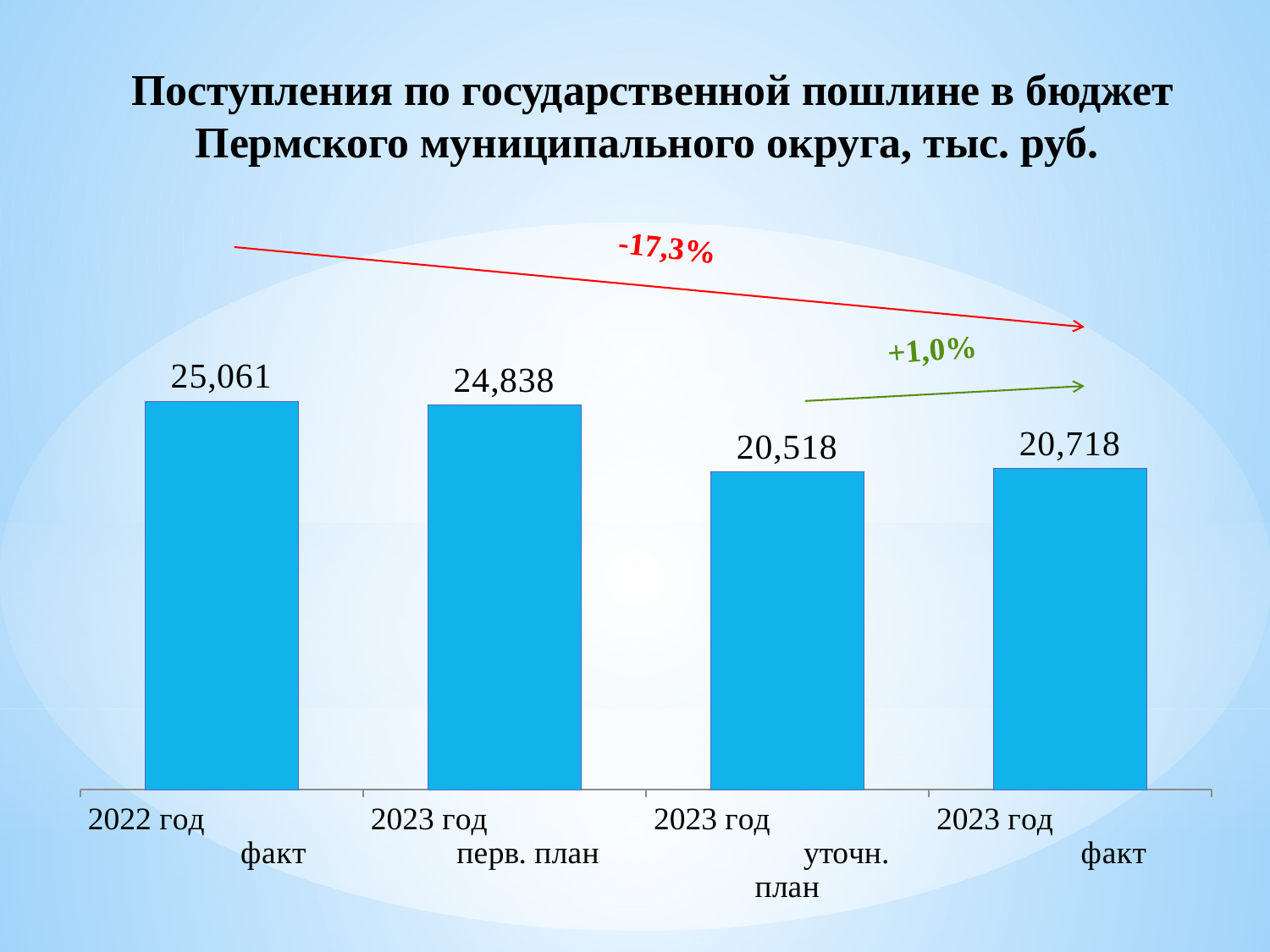
Which category has the lowest value? 2023 год уточн. план What percentage change is shown by the red arrow on the chart? -17,3% Which is larger, the value for 2023 год перв. план or the value for 2023 год факт? 2023 год перв. план What is the value for 2023 год перв. план? 24,838 What is the value for 2023 год факт? 20,718 What is the value for 2022 год факт? 25,061 How many bars are shown in the chart? 4 What is the difference between the 2022 год факт value and the 2023 год факт value? 4,343 What is the difference between the 2023 год факт value and the 2023 год уточн. план value? 200 What is the value for 2023 год уточн. план? 20,518 What kind of chart is shown on the slide? Bar chart Which category has the highest value? 2022 год факт